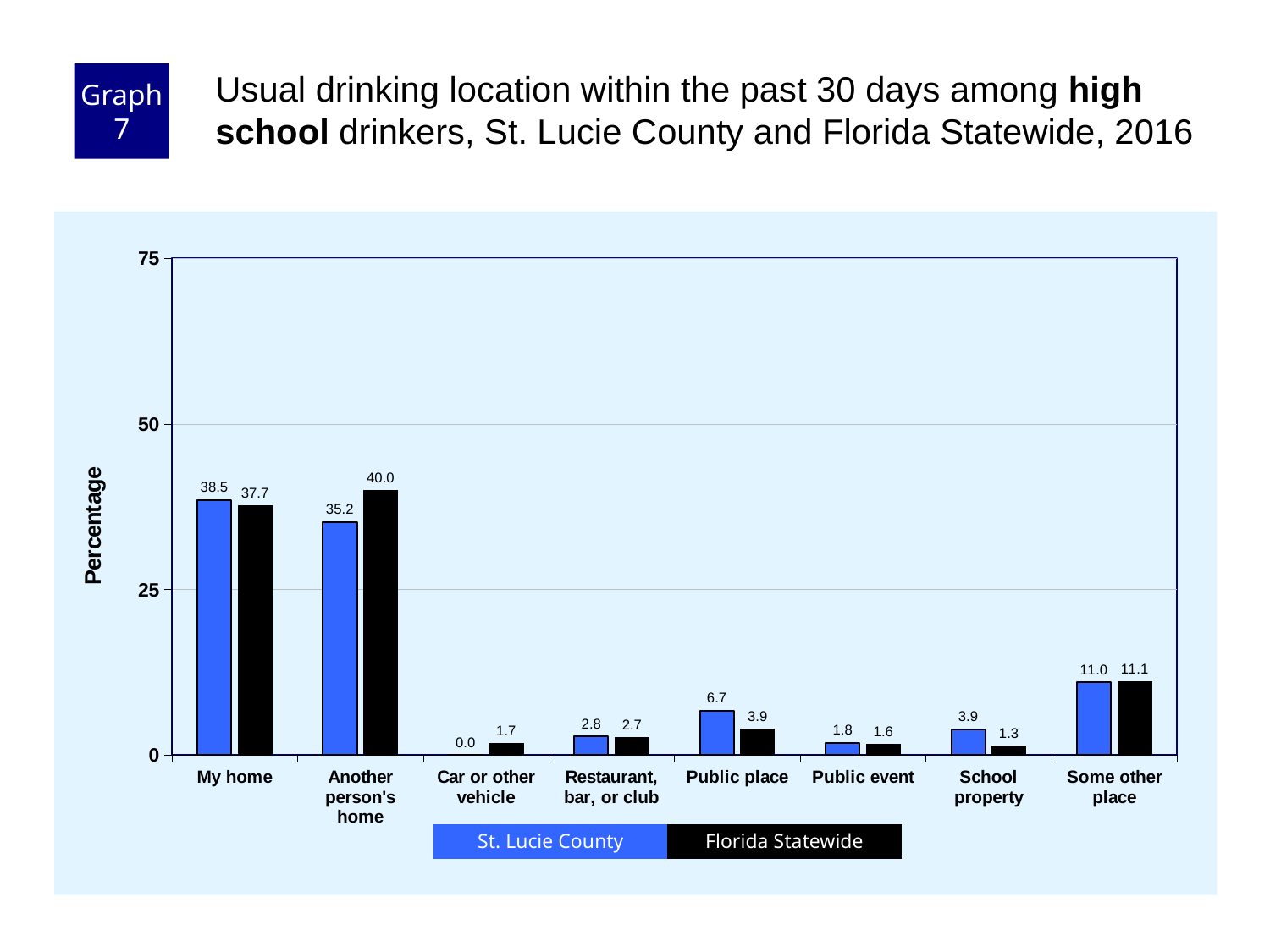
Which category has the highest Florida Statewide value? Another person's home What is the Florida Statewide value for School property? 1.3 What is the difference between the St. Lucie County and Florida Statewide values for Public place? 2.8 Which category has the lowest St. Lucie County value? Car or other vehicle What is the Florida Statewide value for Another person's home? 40.0 What kind of chart is shown on the slide? Bar chart What is the St. Lucie County value for Car or other vehicle? 0.0 Is the St. Lucie County value for My home greater or less than 25? greater How many categories are shown on the x axis? 8 Which is larger for Another person's home: St. Lucie County or Florida Statewide? Florida Statewide How many series does the legend list? 2 What is the St. Lucie County value for My home? 38.5